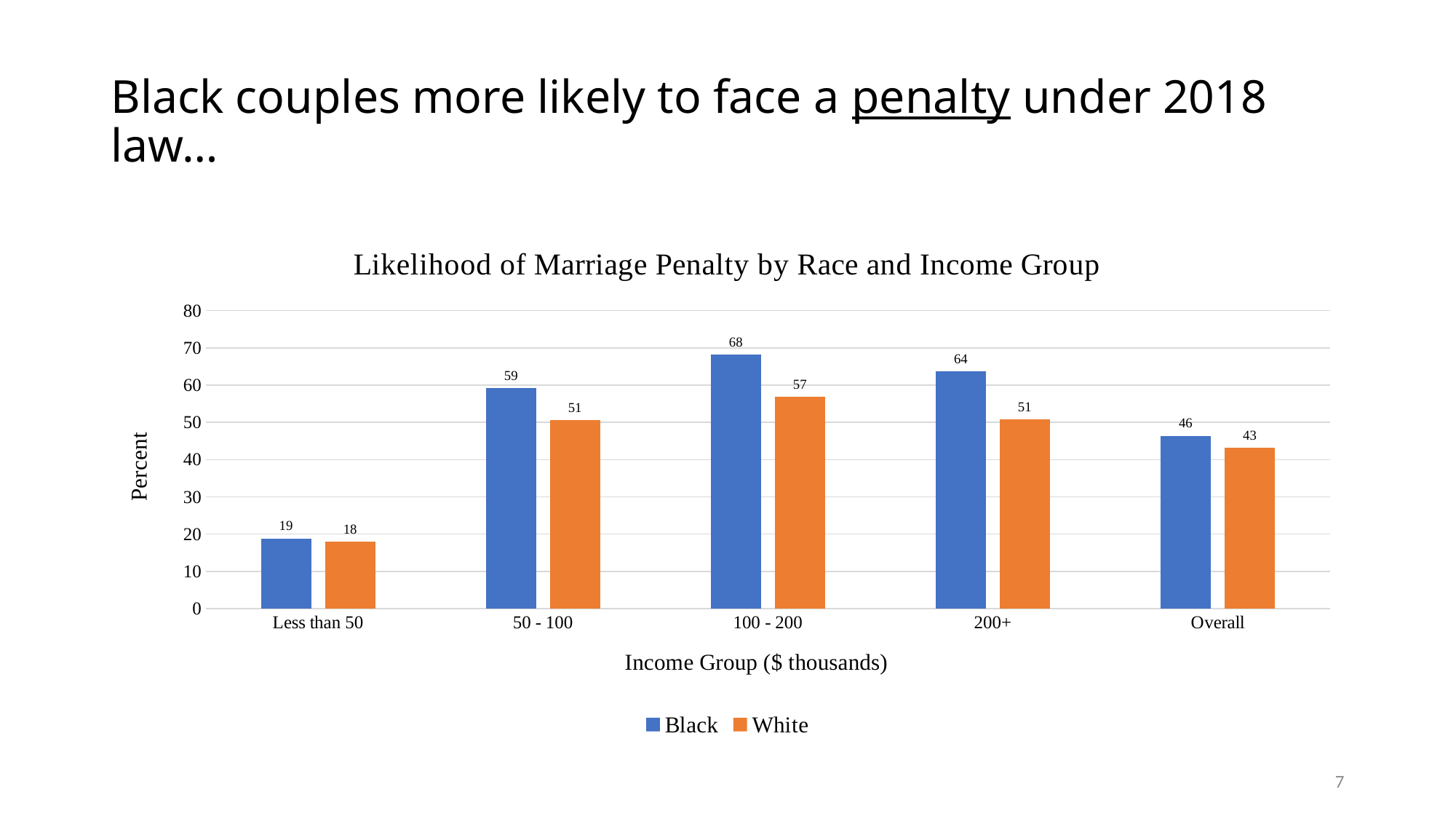
What is the difference between the Black values for the 100 - 200 and 50 - 100 income groups? 9 What is the Overall value for White couples? 43 Which is larger, the Black value for 50 - 100 or the White value for 100 - 200? Black value for 50 - 100 Which income group has the lowest value for White couples? Less than 50 What is the title of the chart? Likelihood of Marriage Penalty by Race and Income Group Which income group has the highest value for Black couples? 100 - 200 What is the value for White couples in the 200+ income group? 51 What is the value for Black couples in the 100 - 200 income group? 68 How many income groups are shown on the x axis? 5 How many series does the legend list? 2 What is the difference between the Black and White values in the 200+ income group? 13 What kind of chart is shown on the slide? Bar chart